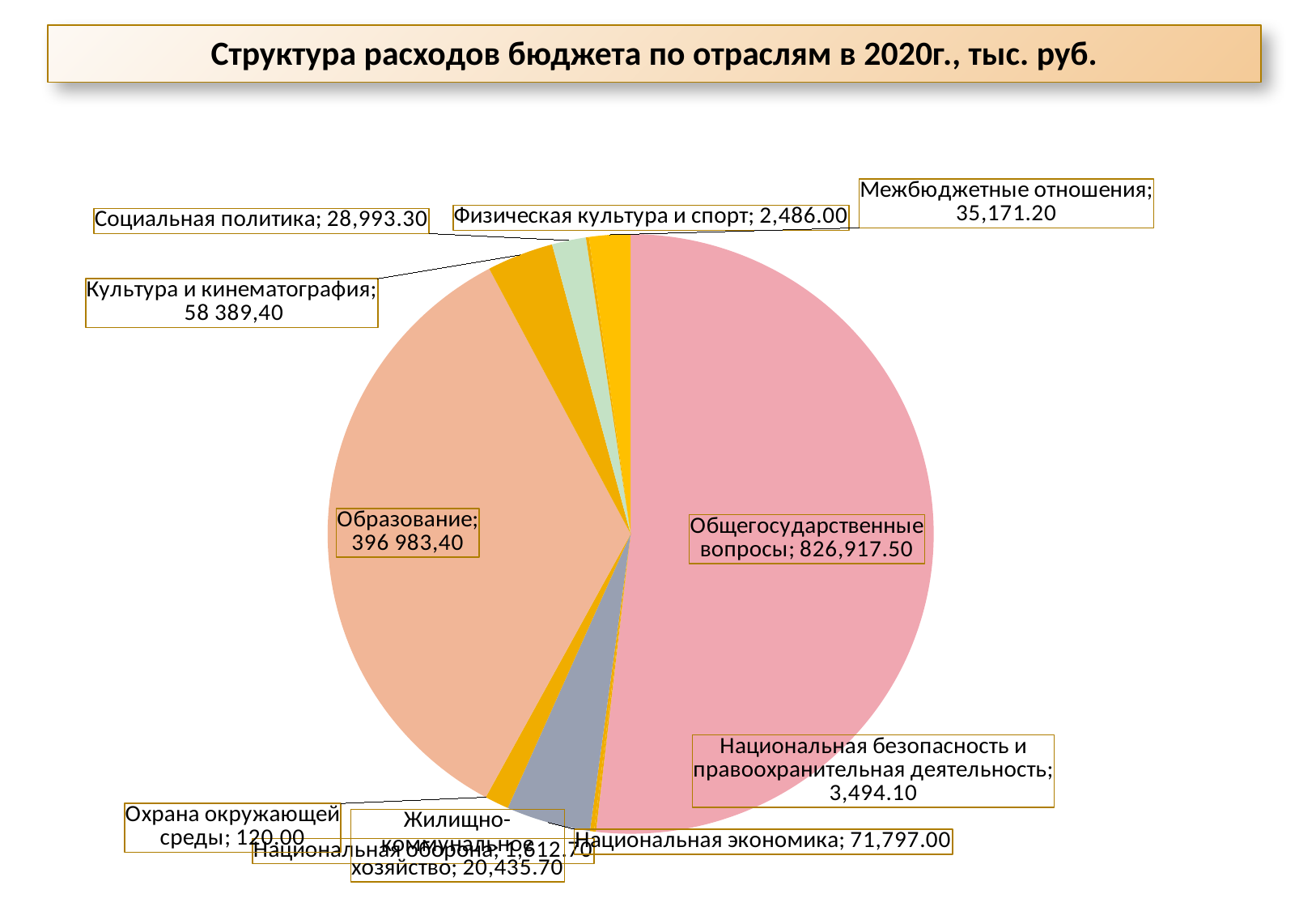
What is the value for Общегосударственные вопросы? 826,917.50 What is the title of the chart? Структура расходов бюджета по отраслям в 2020г., тыс. руб. What is the difference between Общегосударственные вопросы and Образование? 429,934.10 What is the value for Национальная экономика? 71,797.00 What is the value for Охрана окружающей среды? 120.00 What kind of chart is shown on the slide? pie chart Which is larger: Социальная политика or Межбюджетные отношения? Межбюджетные отношения How many categories (slices) does the pie chart have? 11 Which category has the largest slice of the pie? Общегосударственные вопросы What is the value for Межбюджетные отношения? 35,171.20 Which category has the smallest value? Охрана окружающей среды What is the value for Образование? 396 983,40